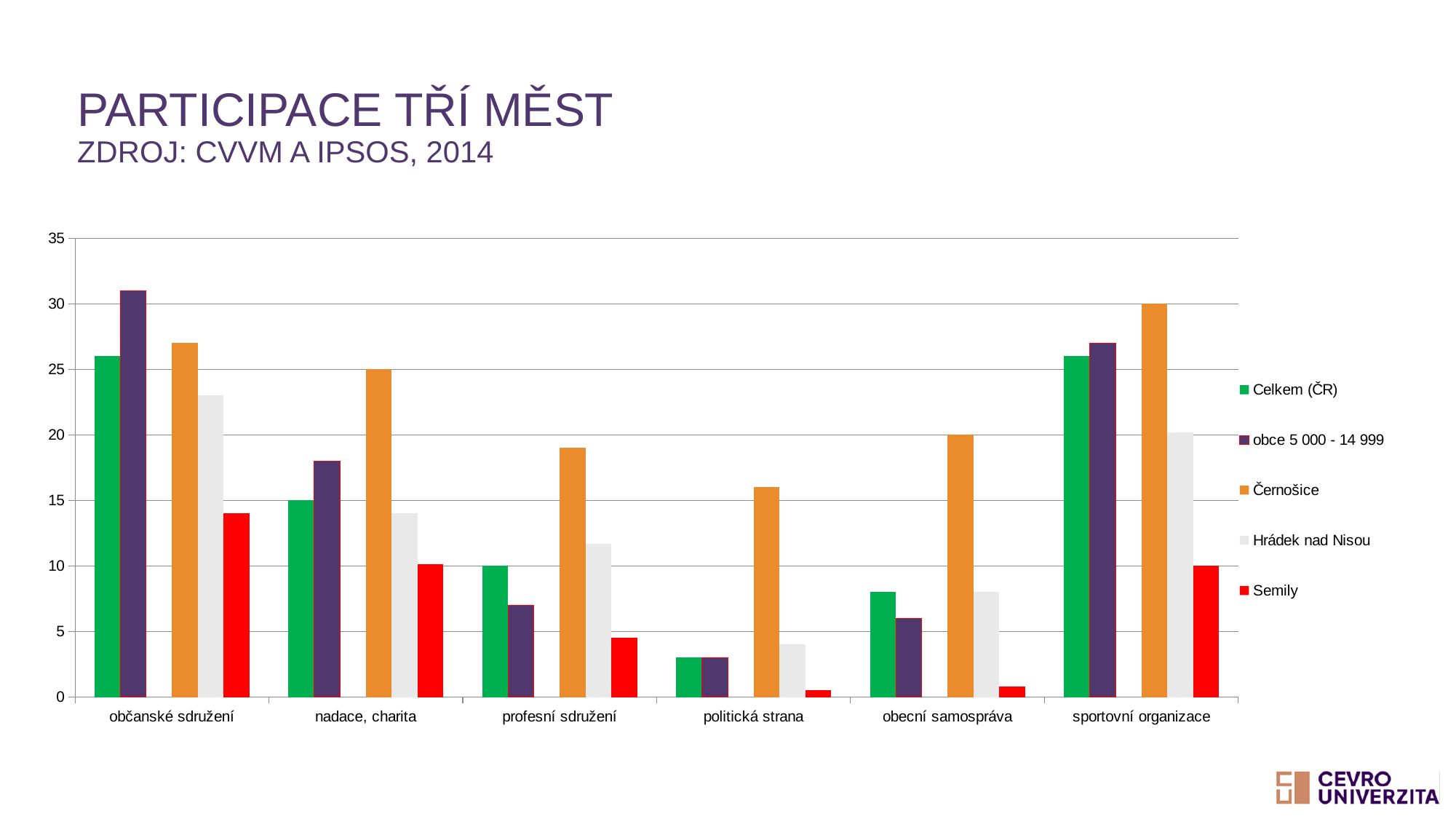
How many series does the legend list? 5 What kind of chart is shown on the slide? bar chart In the category nadace, charita, which is larger: Celkem (ČR) or obce 5 000 - 14 999? obce 5 000 - 14 999 Is the value for Hrádek nad Nisou in občanské sdružení greater or less than 25? less In which category does Semily have its lowest value? politická strana In which category does Černošice have its highest value? sportovní organizace How many categories are shown on the x axis? 6 What is the value for Celkem (ČR) in the category nadace, charita? 15 Which series has the highest value in the category občanské sdružení? obce 5 000 - 14 999 What is the source given in the slide subtitle? CVVM a IPSOS, 2014 What is the value for Černošice in the category obecní samospráva? 20 What is the value for Černošice in the category sportovní organizace? 30